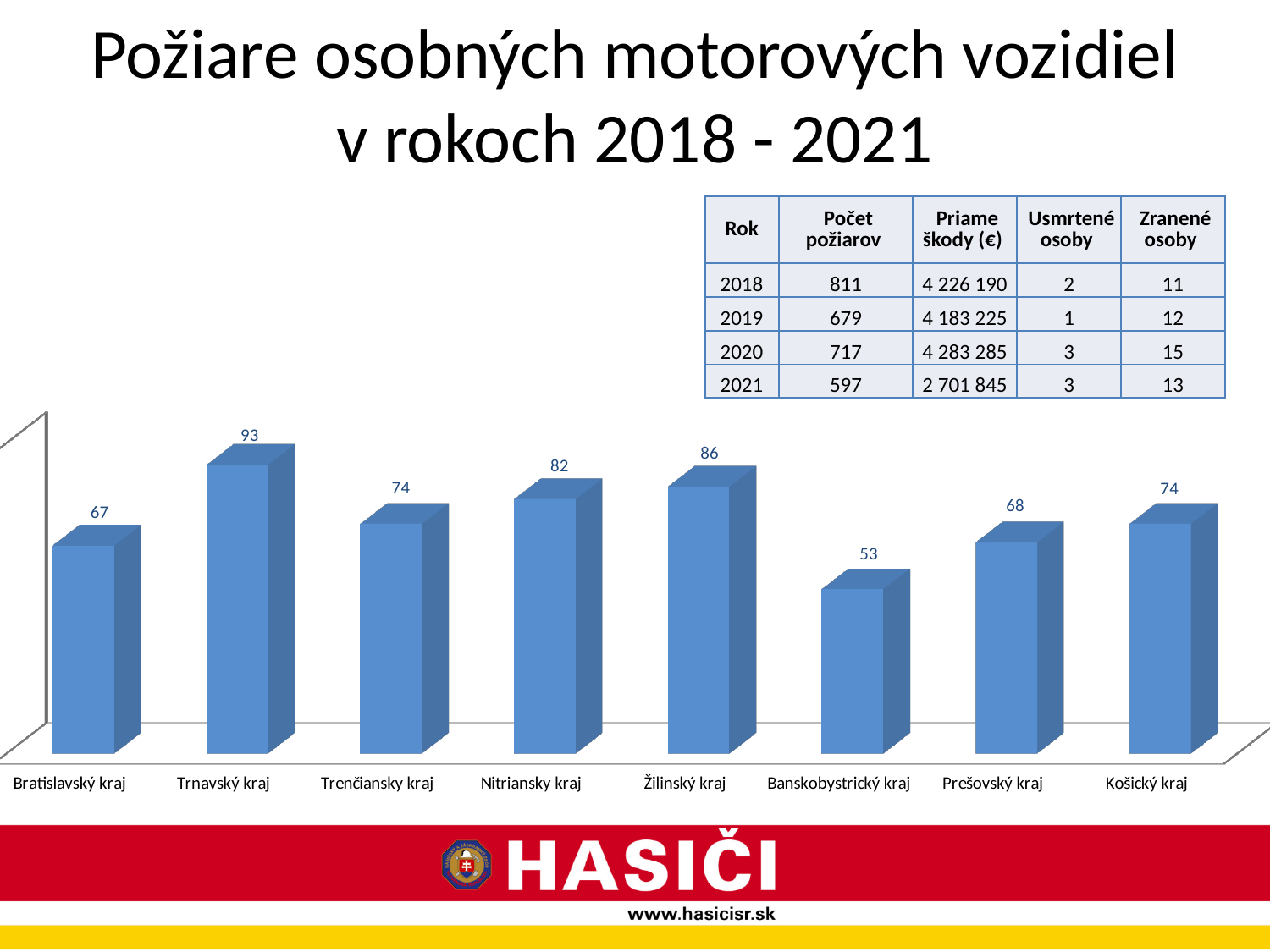
Which two regions share the same value of 74? Trenčiansky kraj and Košický kraj What kind of chart is shown on the slide? bar chart What is the difference between the values for Trnavský kraj and Banskobystrický kraj? 40 What is the difference between the values for Žilinský kraj and Nitriansky kraj? 4 Which is larger, the value for Nitriansky kraj or the value for Bratislavský kraj? Nitriansky kraj What is the value shown for Trnavský kraj? 93 What is the value shown for Banskobystrický kraj? 53 What is the value shown for Žilinský kraj? 86 How many regions (categories) are shown in the chart? 8 Which region has the lowest bar in the chart? Banskobystrický kraj What is the value shown for Prešovský kraj? 68 Which region has the highest bar in the chart? Trnavský kraj